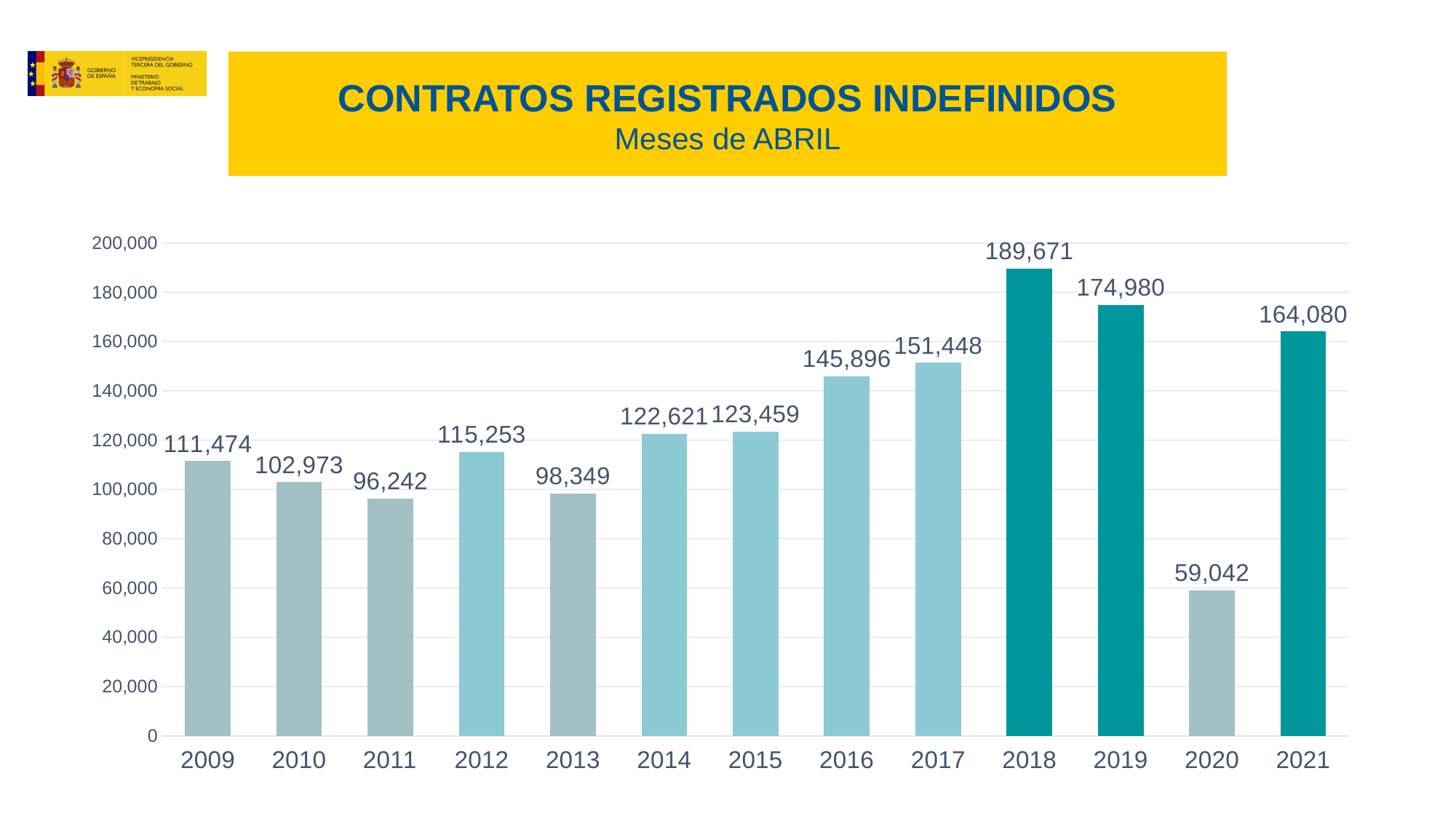
How many years are shown on the x axis? 13 What is the value for 2018? 189,671 What is the value for 2013? 98,349 Which year has the lowest value? 2020 What is the difference between the values for 2018 and 2019? 14,691 What is the title of the chart? CONTRATOS REGISTRADOS INDEFINIDOS What kind of chart is this? bar chart Is the value for 2017 greater or less than 140,000? greater What is the difference between the values for 2021 and 2020? 105,038 Which year has the highest value? 2018 What is the value for 2020? 59,042 Which is larger, the value for 2011 or the value for 2013? 2013